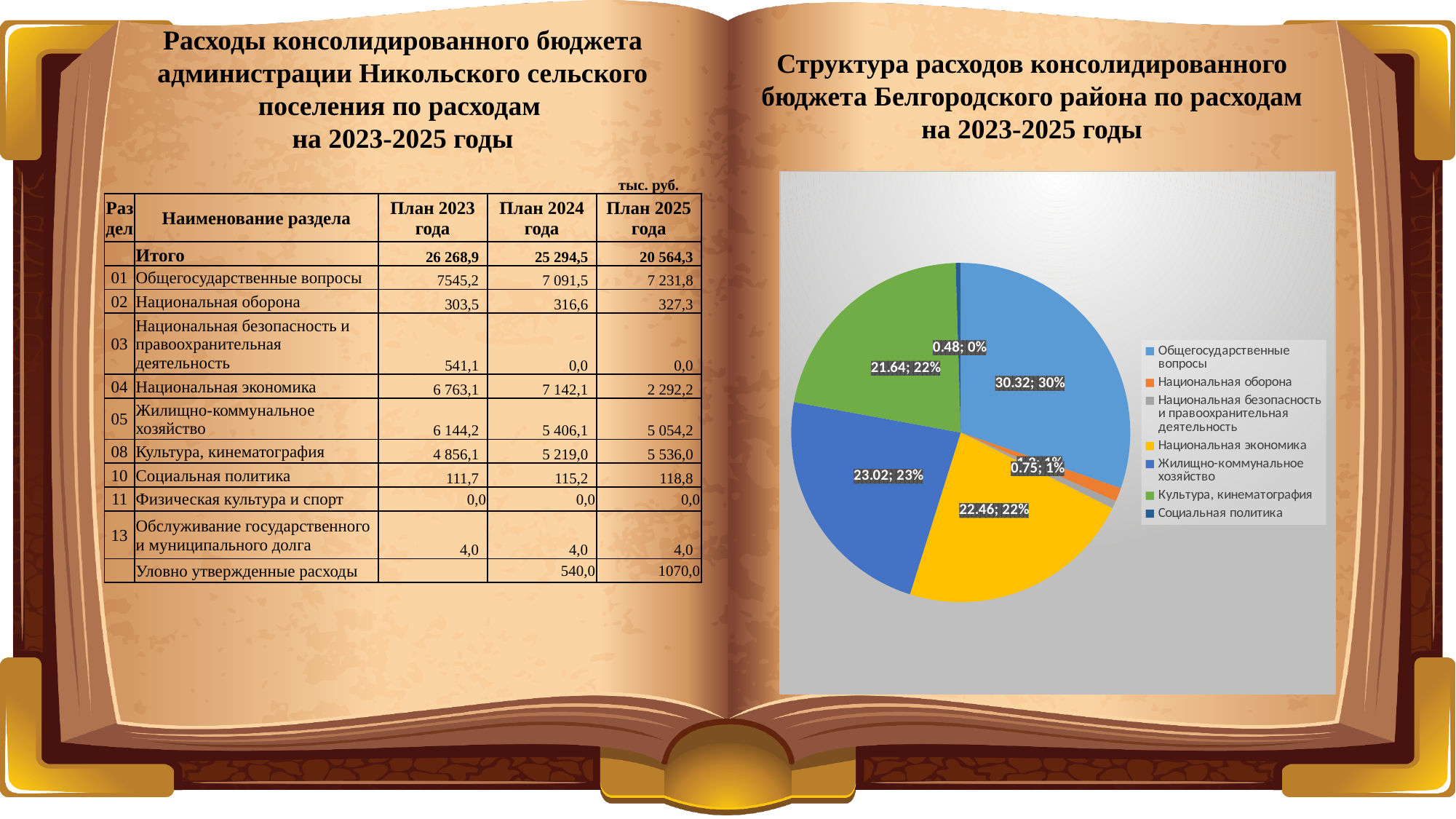
What value is labelled on the pie chart for Социальная политика? 0.48; 0% What value is labelled on the pie chart for Жилищно-коммунальное хозяйство? 23.02; 23% What value is labelled on the pie chart for Общегосударственные вопросы? 30.32; 30% What is the difference between the labelled values for Общегосударственные вопросы and Национальная экономика in the pie chart? 7.86 Which category has the largest slice in the pie chart? Общегосударственные вопросы What kind of chart is shown on the right page of the slide? Pie chart How many categories does the legend of the pie chart list? 7 What value is labelled on the pie chart for Национальная экономика? 22.46; 22% What value is labelled on the pie chart for Культура, кинематография? 21.64; 22% In the pie chart, which is larger: Жилищно-коммунальное хозяйство or Национальная экономика? Жилищно-коммунальное хозяйство What colour is the Национальная экономика slice in the pie chart? Yellow Which category has the smallest slice in the pie chart? Социальная политика